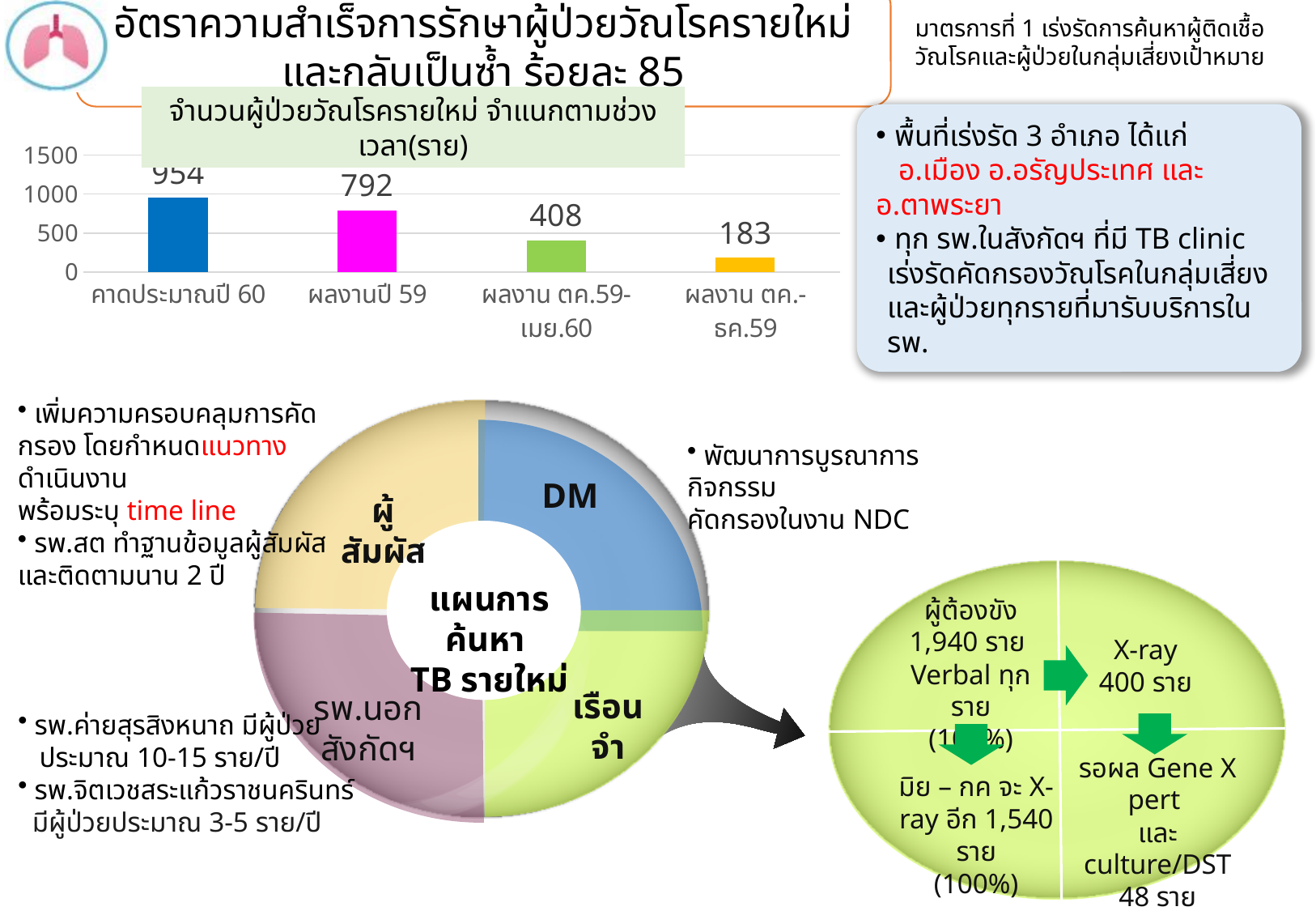
In the bar chart, what is the value for ผลงานปี 59? 792 In the bar chart, what is the value for ผลงาน ตค.59-เมย.60? 408 In the bar chart, which category has the lowest value? ผลงาน ตค.-ธค.59 How many categories are shown in the bar chart? 4 In the bar chart, do the values rise or fall from left to right across the categories? fall In the bar chart, what is the difference between ผลงาน ตค.59-เมย.60 and ผลงาน ตค.-ธค.59? 225 In the bar chart, which category has the highest value? คาดประมาณปี 60 What type of chart is used to show จำนวนผู้ป่วยวัณโรครายใหม่ จำแนกตามช่วงเวลา(ราย)? bar chart In the bar chart, which is larger: ผลงานปี 59 or ผลงาน ตค.59-เมย.60? ผลงานปี 59 In the bar chart, what is the difference between คาดประมาณปี 60 and ผลงานปี 59? 162 In the bar chart, what is the value for ผลงาน ตค.-ธค.59? 183 In the bar chart, what is the value for คาดประมาณปี 60? 954